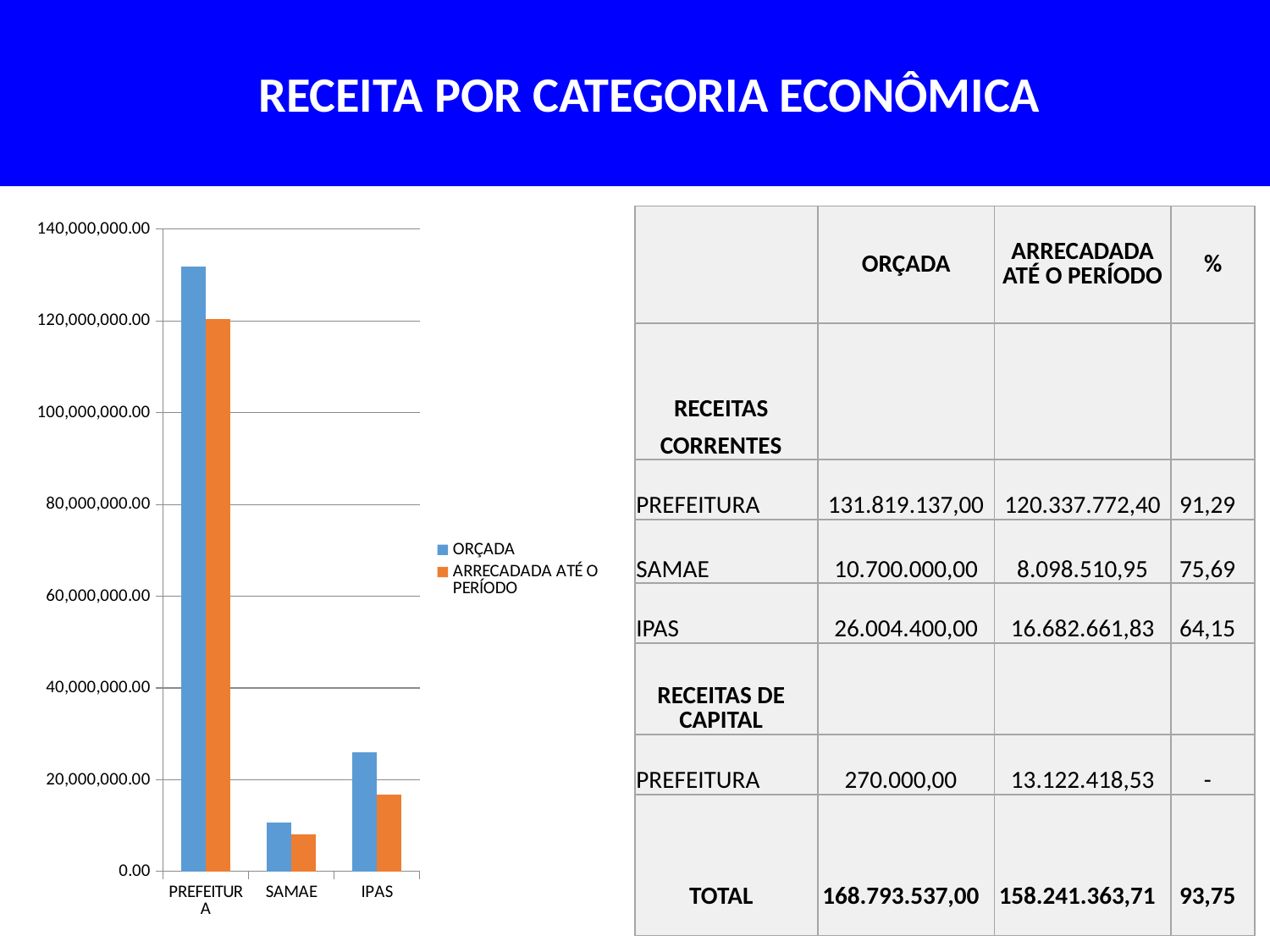
Which colour represents the ORÇADA series in the chart's legend? blue How many series does the chart's legend list? 2 In the chart, is the ARRECADADA ATÉ O PERÍODO value for SAMAE greater or less than 20,000,000.00? less In the chart, is the ORÇADA bar for IPAS or for SAMAE taller? IPAS How many categories are shown on the x axis of the chart? 3 According to the table on the slide, what is the ORÇADA value for SAMAE? 10.700.000,00 In the chart, is the ORÇADA value for PREFEITURA greater or less than 120,000,000.00? greater In the chart, is the ORÇADA value for IPAS greater or less than 20,000,000.00? greater What kind of chart is shown on the slide? bar chart Which category has the lowest ORÇADA bar in the chart? SAMAE Which category has the highest ORÇADA bar in the chart? PREFEITURA According to the table on the slide, what is the ARRECADADA ATÉ O PERÍODO value for IPAS? 16.682.661,83